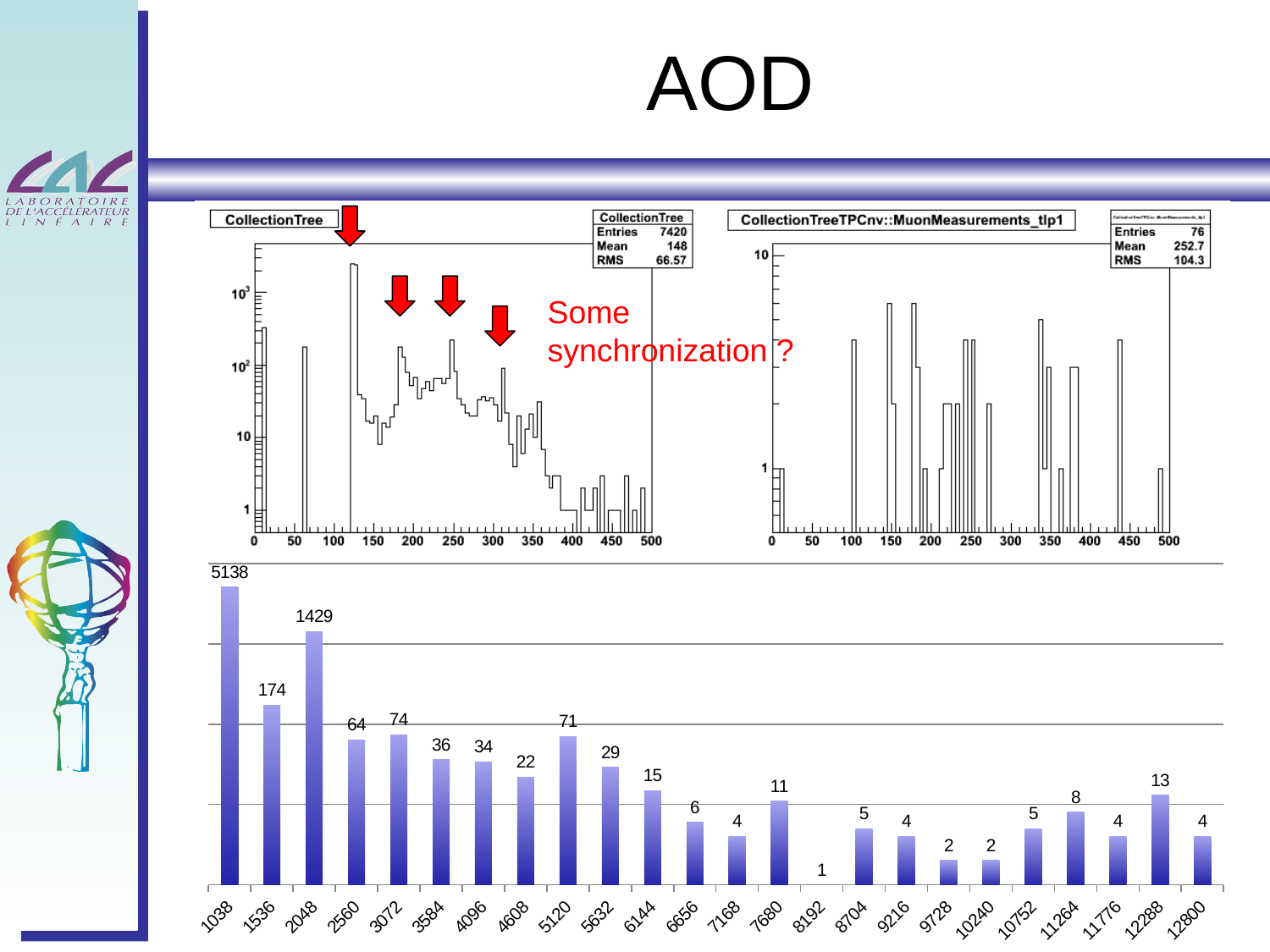
In the top-left histogram titled CollectionTree, how many entries are listed in the statistics box? 7420 In the bottom bar chart, what is the difference between the values for 1536 and 2560? 110 In the top-right histogram titled CollectionTreeTPCnv::MuonMeasurements_tlp1, what is the Mean listed in the statistics box? 252.7 In the bottom bar chart, what is the value for the category 5120? 71 How many categories are shown on the x axis of the bottom bar chart? 24 In the bottom bar chart, which category has the lowest value? 8192 In the bottom bar chart, which is larger, the value for 3072 or the value for 3584? 3072 In the bottom bar chart, what is the value for the category 1038? 5138 In the bottom bar chart, what is the value for the category 2048? 1429 What kind of chart is the chart at the bottom of the slide? bar chart In the bottom bar chart, what is the value for the category 12288? 13 In the bottom bar chart, which category has the highest value? 1038